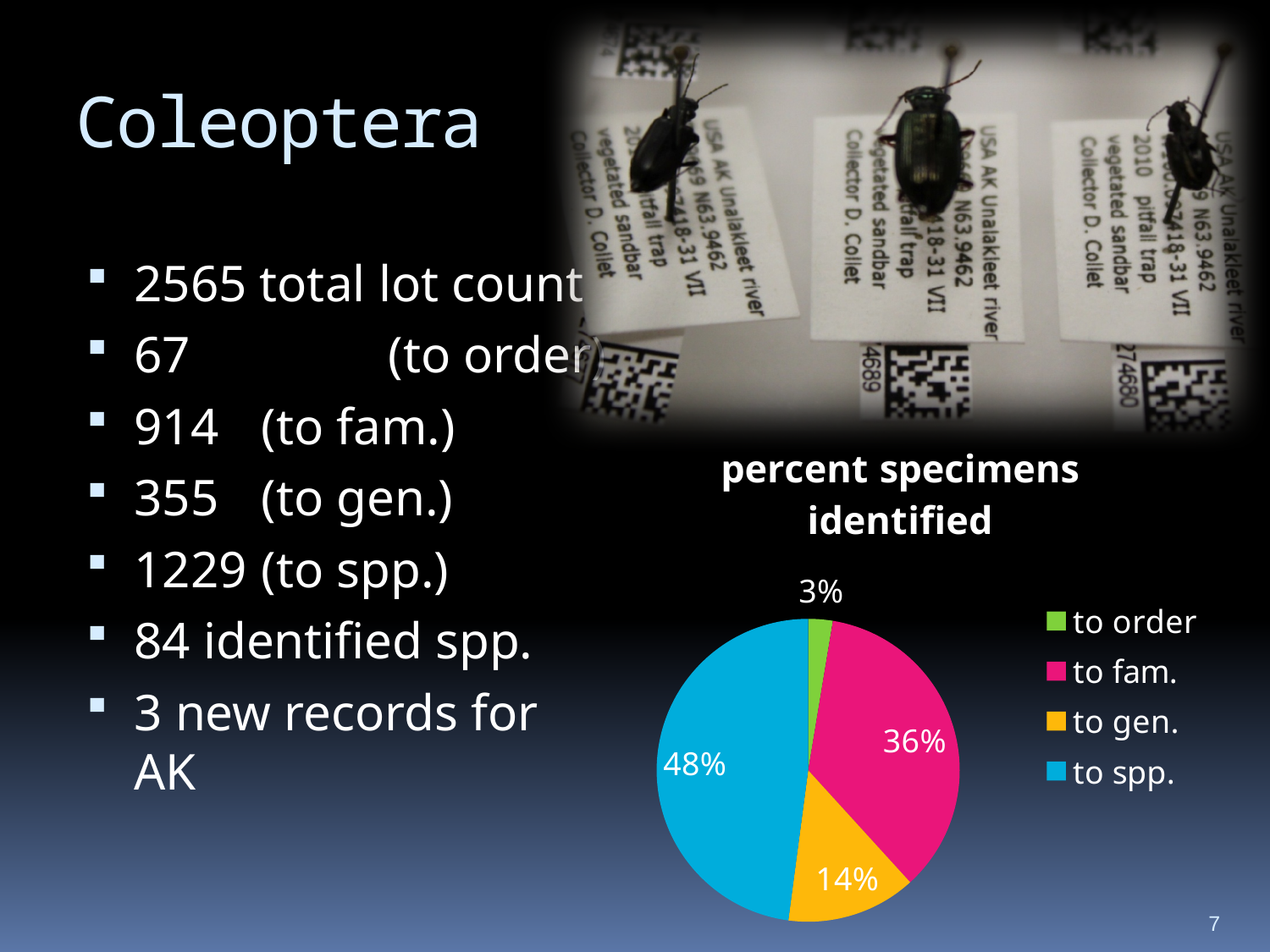
What percentage of specimens were identified to family (to fam.)? 36% What percentage of specimens were identified to species (to spp.)? 48% What is the title of the chart? percent specimens identified How many categories does the pie chart show? 4 What percentage of specimens were identified only to order? 3% What is the difference in percentage points between the 'to spp.' and 'to fam.' slices? 12 What colour is the 'to spp.' slice in the pie chart? blue Which category has the largest share of the pie? to spp. What type of chart is shown on the slide? pie chart Which is larger, the 'to gen.' slice or the 'to fam.' slice? to fam. Which category has the smallest share of the pie? to order What percentage of specimens were identified to genus (to gen.)? 14%